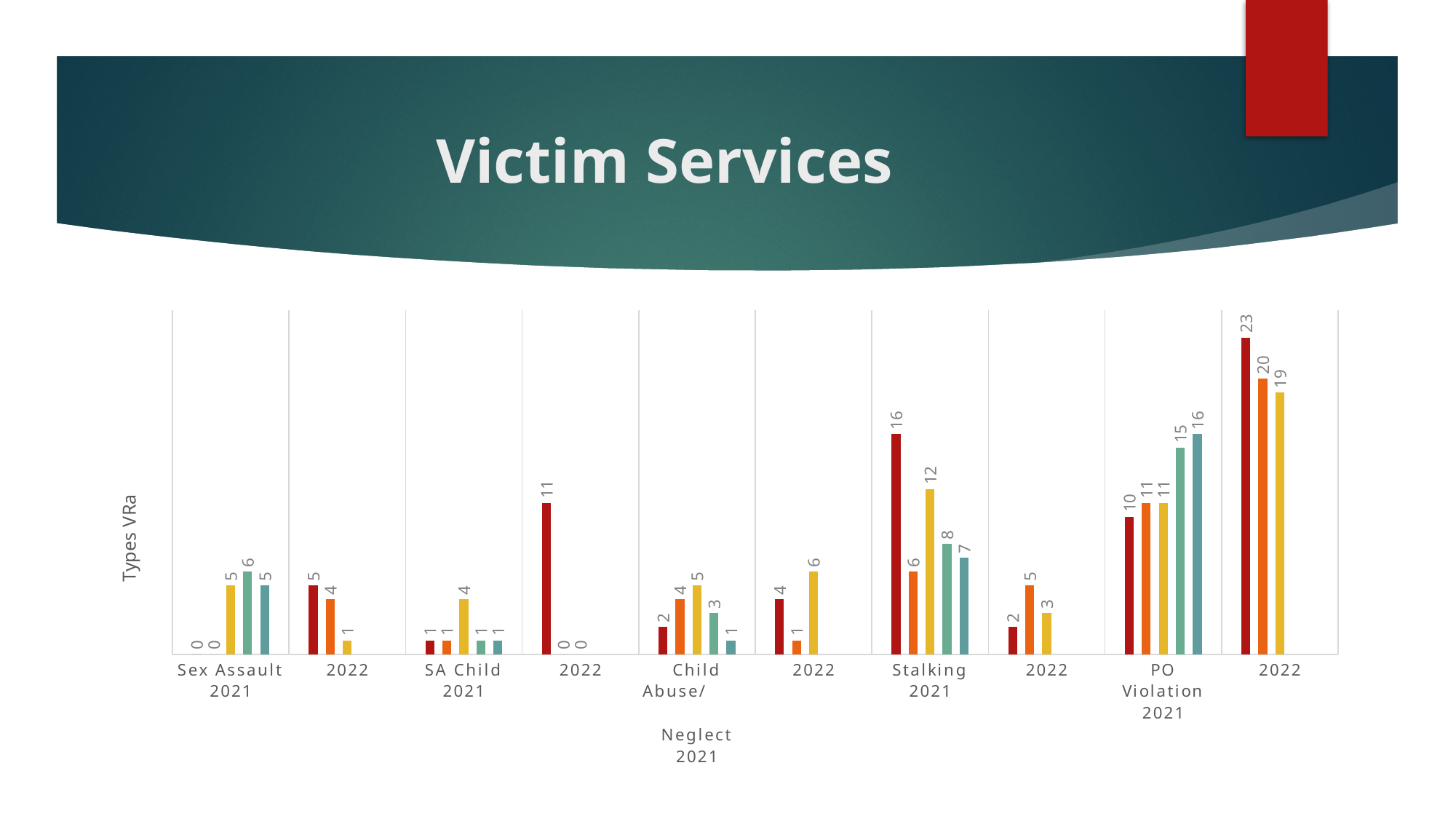
What is the value of the dark red bar for Stalking 2021? 16 What type of chart is shown on the slide? bar chart What is the value of the dark red bar for PO Violation 2022? 23 What is the value of the yellow bar for Child Abuse/Neglect 2022? 6 How many categories are shown along the x axis of the chart? 10 What is the label on the vertical axis of the chart? Types VRa What is the difference between the yellow bar for Stalking 2021 and the yellow bar for Stalking 2022? 9 What is the value of the dark red bar for SA Child 2022? 11 What is the difference between the dark red bar for PO Violation 2022 and the dark red bar for PO Violation 2021? 13 Which category contains the tallest bar in the chart? PO Violation 2022 Which is larger: the dark red bar for Stalking 2021 or the dark red bar for Stalking 2022? Stalking 2021